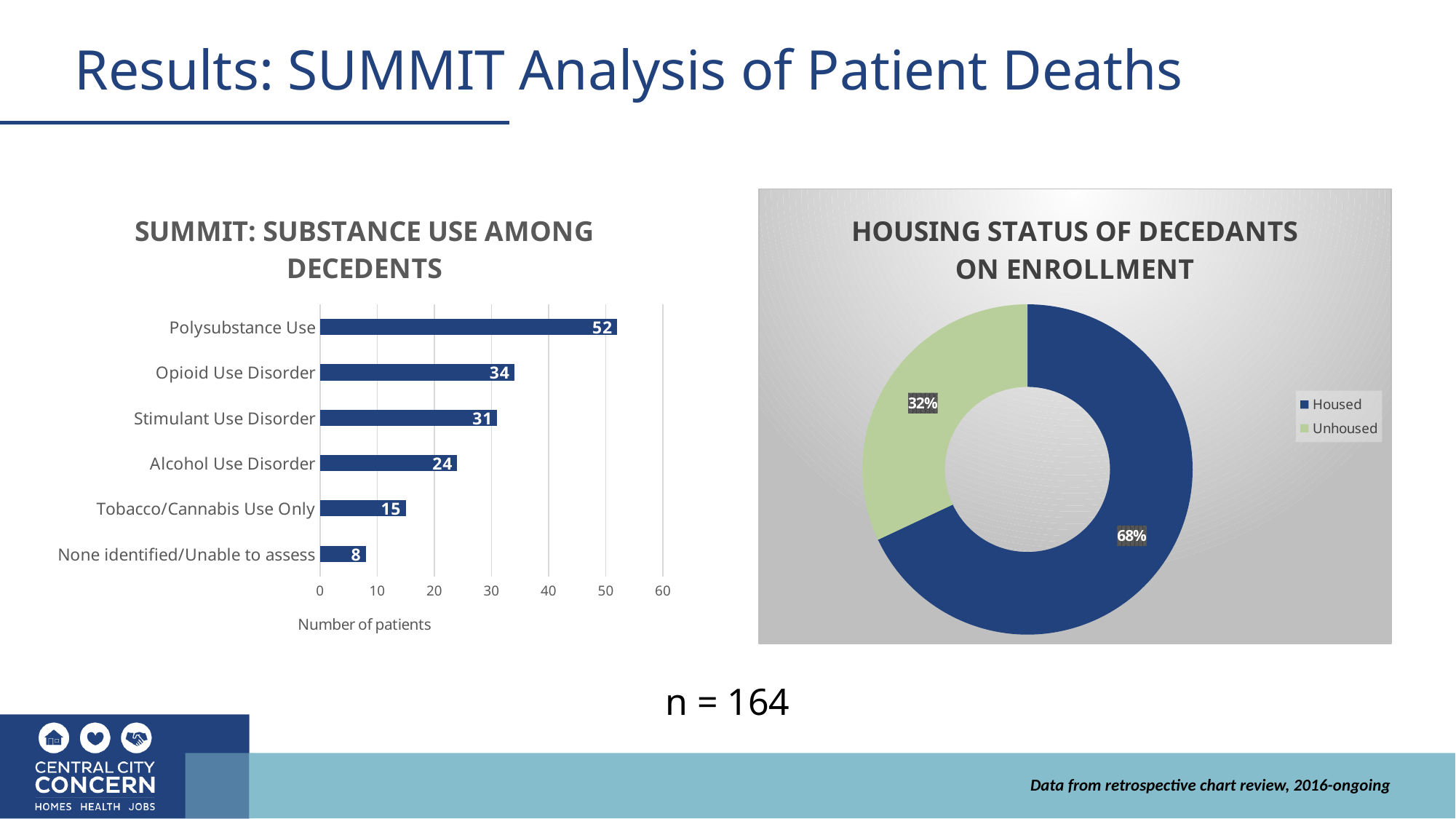
In the 'SUMMIT: Substance Use Among Decedents' chart, which category has the highest number of patients? Polysubstance Use In the 'SUMMIT: Substance Use Among Decedents' chart, what is the difference between Opioid Use Disorder and Stimulant Use Disorder? 3 In the 'SUMMIT: Substance Use Among Decedents' chart, what is the label of the horizontal axis? Number of patients How many entries does the legend of the 'Housing Status of Decedants on Enrollment' chart list? 2 In the 'Housing Status of Decedants on Enrollment' chart, what share of decedents were Unhoused? 32% In the 'SUMMIT: Substance Use Among Decedents' chart, what is the value for Alcohol Use Disorder? 24 What kind of chart is 'SUMMIT: Substance Use Among Decedents'? Bar chart In the 'SUMMIT: Substance Use Among Decedents' chart, how many categories are shown? 6 In the 'SUMMIT: Substance Use Among Decedents' chart, how many patients had Polysubstance Use? 52 In the 'SUMMIT: Substance Use Among Decedents' chart, which is larger: Tobacco/Cannabis Use Only or Alcohol Use Disorder? Alcohol Use Disorder In the 'Housing Status of Decedants on Enrollment' chart, what share of decedents were Housed? 68% In the 'SUMMIT: Substance Use Among Decedents' chart, which category has the lowest number of patients? None identified/Unable to assess